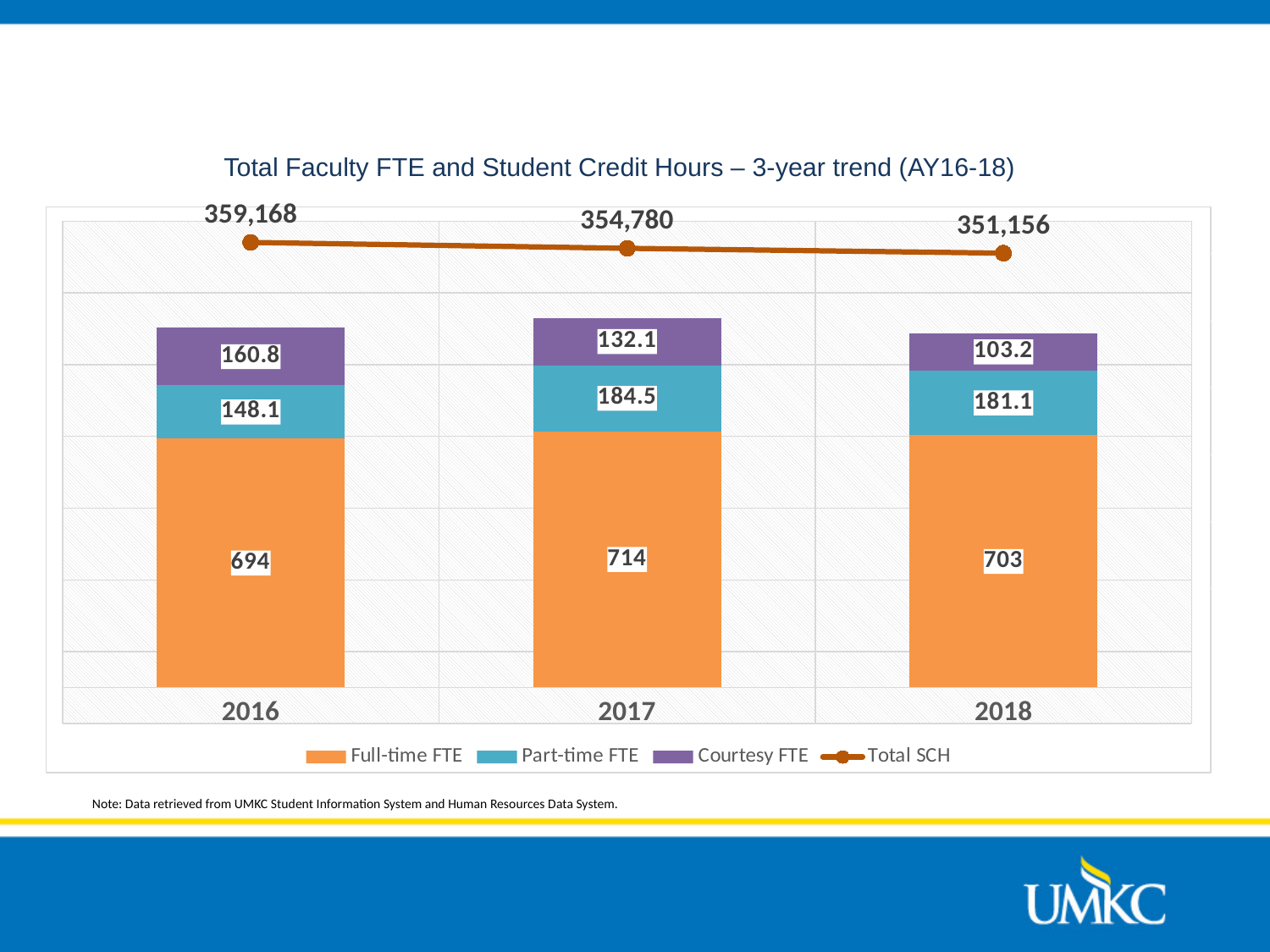
What kind of chart is this? Stacked bar chart with a line Is the Full-time FTE larger in 2016 or in 2018? 2018 What is the Total SCH value for 2016? 359,168 What is the total FTE (Full-time, Part-time and Courtesy) for the 2017 stacked bar? 1030.6 Does the Total SCH line rise or fall from 2016 to 2018? Fall How many series does the legend list? 4 What is the Full-time FTE value for 2017? 714 What is the difference between the Total SCH values for 2016 and 2018? 8,012 How many years are shown on the x axis? 3 What is the Courtesy FTE value for 2018? 103.2 Which year has the lowest Courtesy FTE? 2018 Which year has the highest Part-time FTE? 2017